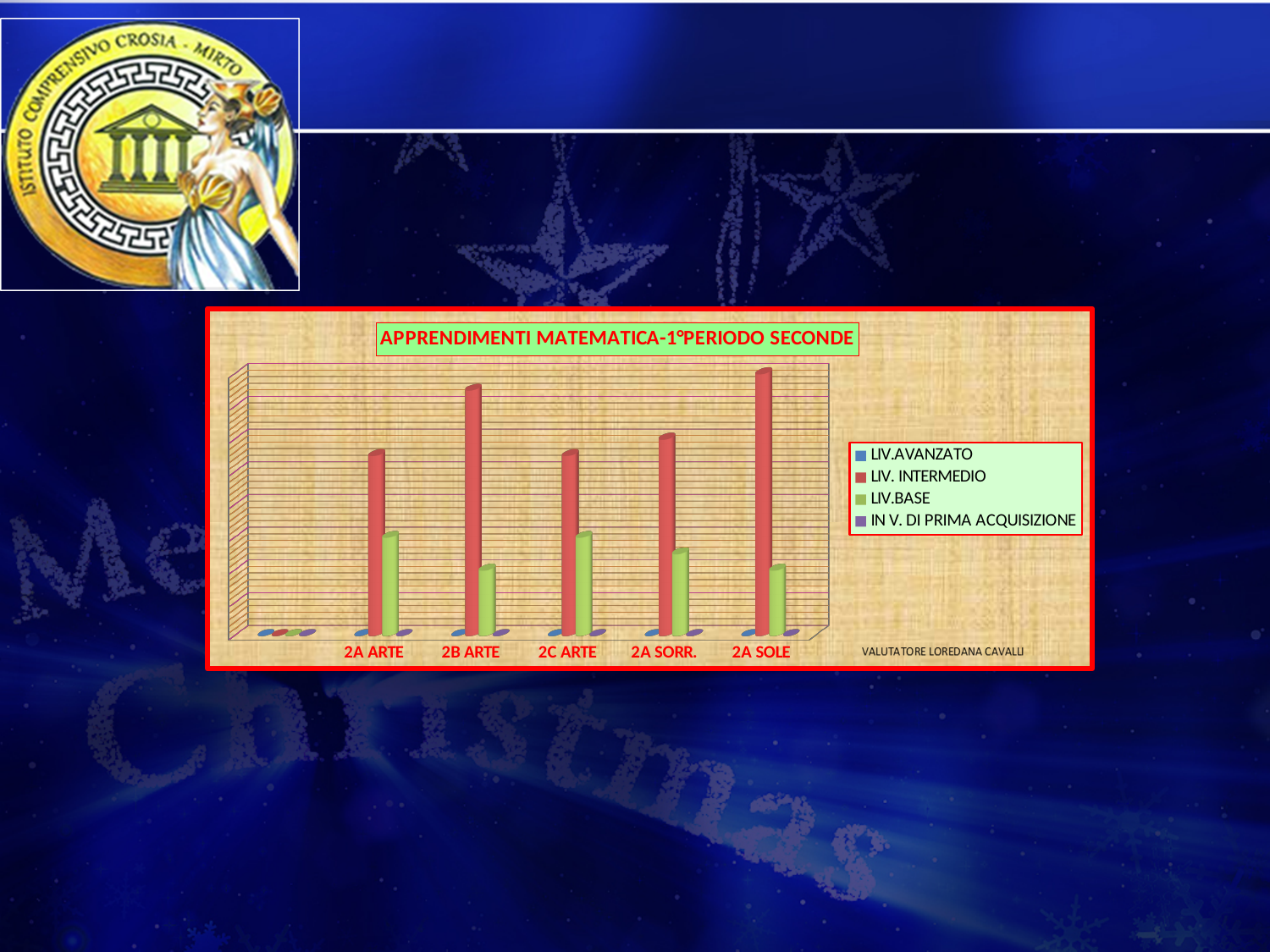
Is the LIV.BASE bar higher for 2A ARTE or for 2B ARTE? 2A ARTE Which series is represented by the red bars in the chart? LIV. INTERMEDIO What kind of chart is shown on the slide? Bar chart Which class has the highest LIV. INTERMEDIO bar? 2A SOLE Is the LIV. INTERMEDIO bar higher for 2B ARTE or for 2A SORR.? 2B ARTE Do the LIV. INTERMEDIO bars rise steadily from 2A ARTE to 2A SOLE? No How many classes (categories) are shown on the x axis of the chart? 5 For 2A SOLE, which is larger: the LIV. INTERMEDIO bar or the LIV.BASE bar? LIV. INTERMEDIO How many series does the chart legend list? 4 Which series has the tallest bar in every class? LIV. INTERMEDIO What is the title of the chart? APPRENDIMENTI MATEMATICA-1°PERIODO SECONDE